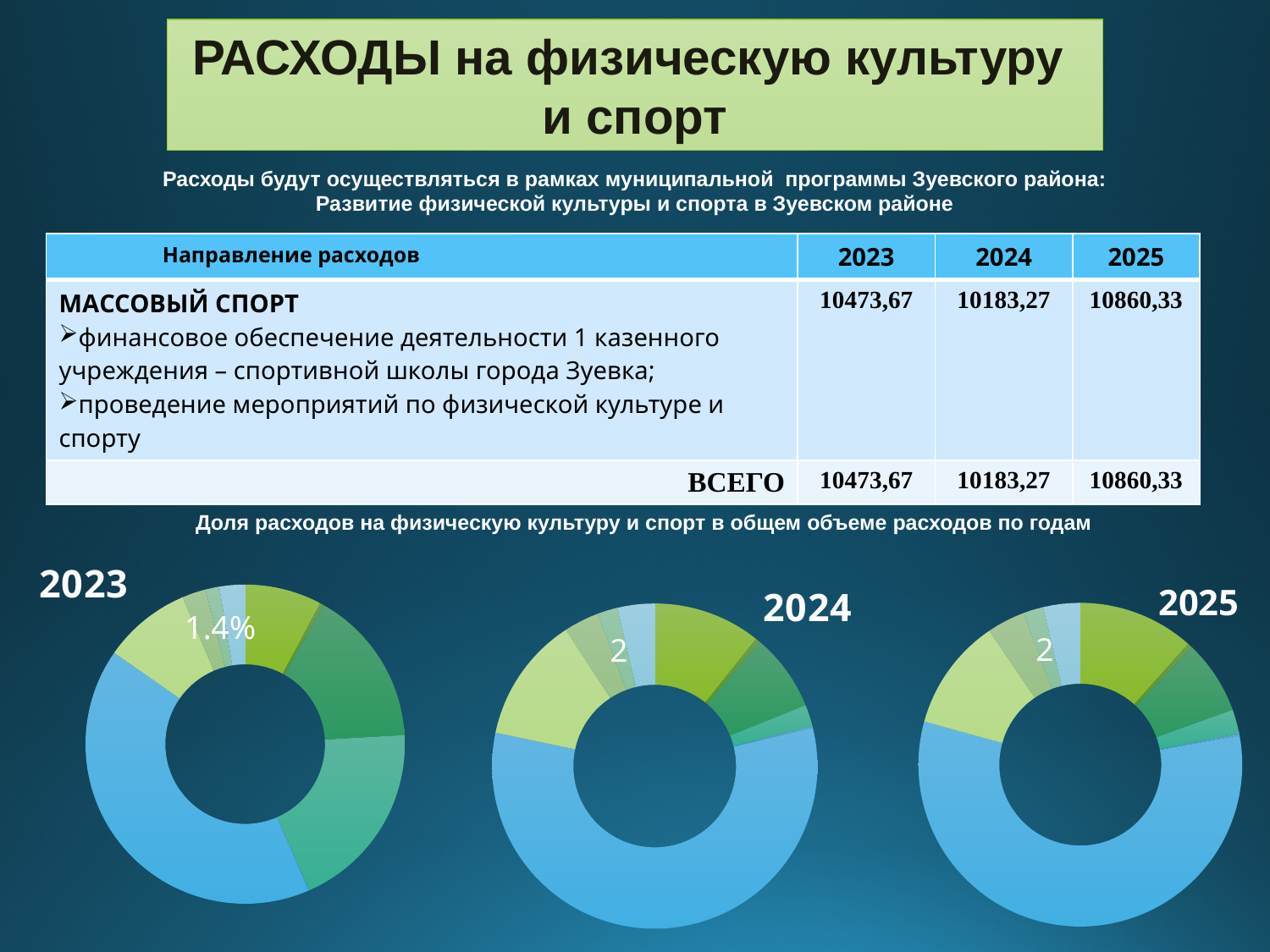
What kind of chart is used to show the share of expenditure on physical culture and sport by year? doughnut (pie) chart In the 2024 doughnut chart, is the labelled slice (marked 2) larger or smaller than the big blue slice? smaller In the 2023 doughnut chart, what percentage is printed as the data label on the light green slice? 1.4% In the 2023 doughnut chart, is the slice labelled 1.4% the largest or one of the smallest slices? one of the smallest How many doughnut charts are shown on the slide? 3 Which years are the three doughnut charts labelled with? 2023, 2024, 2025 What is the title printed above the three doughnut charts? Доля расходов на физическую культуру и спорт в общем объеме расходов по годам